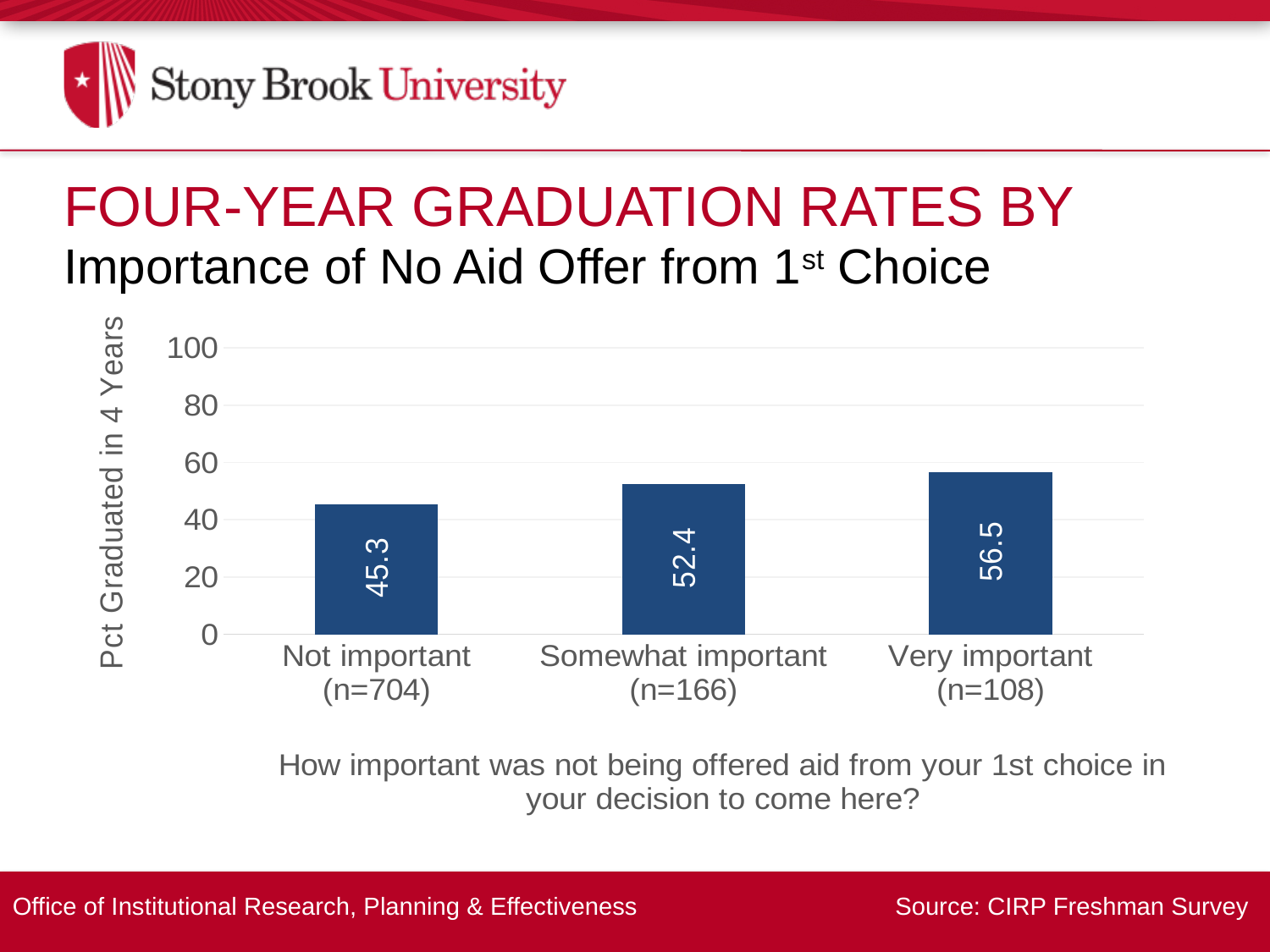
Which category has the lowest four-year graduation rate? Not important Which category has the highest four-year graduation rate? Very important What kind of chart is shown on the slide? Bar chart Is the value for 'Not important' greater or less than 60? less What is the four-year graduation rate for the 'Very important' group? 56.5 How many categories are shown on the x axis? 3 What is the four-year graduation rate for the 'Somewhat important' group? 52.4 Do the graduation rates rise or fall from 'Not important' to 'Very important'? Rise What is the difference in graduation rate between the 'Very important' and 'Not important' groups? 11.2 What is the four-year graduation rate for the 'Not important' group? 45.3 Which group has a higher graduation rate, 'Somewhat important' or 'Very important'? Very important What is the difference in graduation rate between the 'Somewhat important' and 'Not important' groups? 7.1